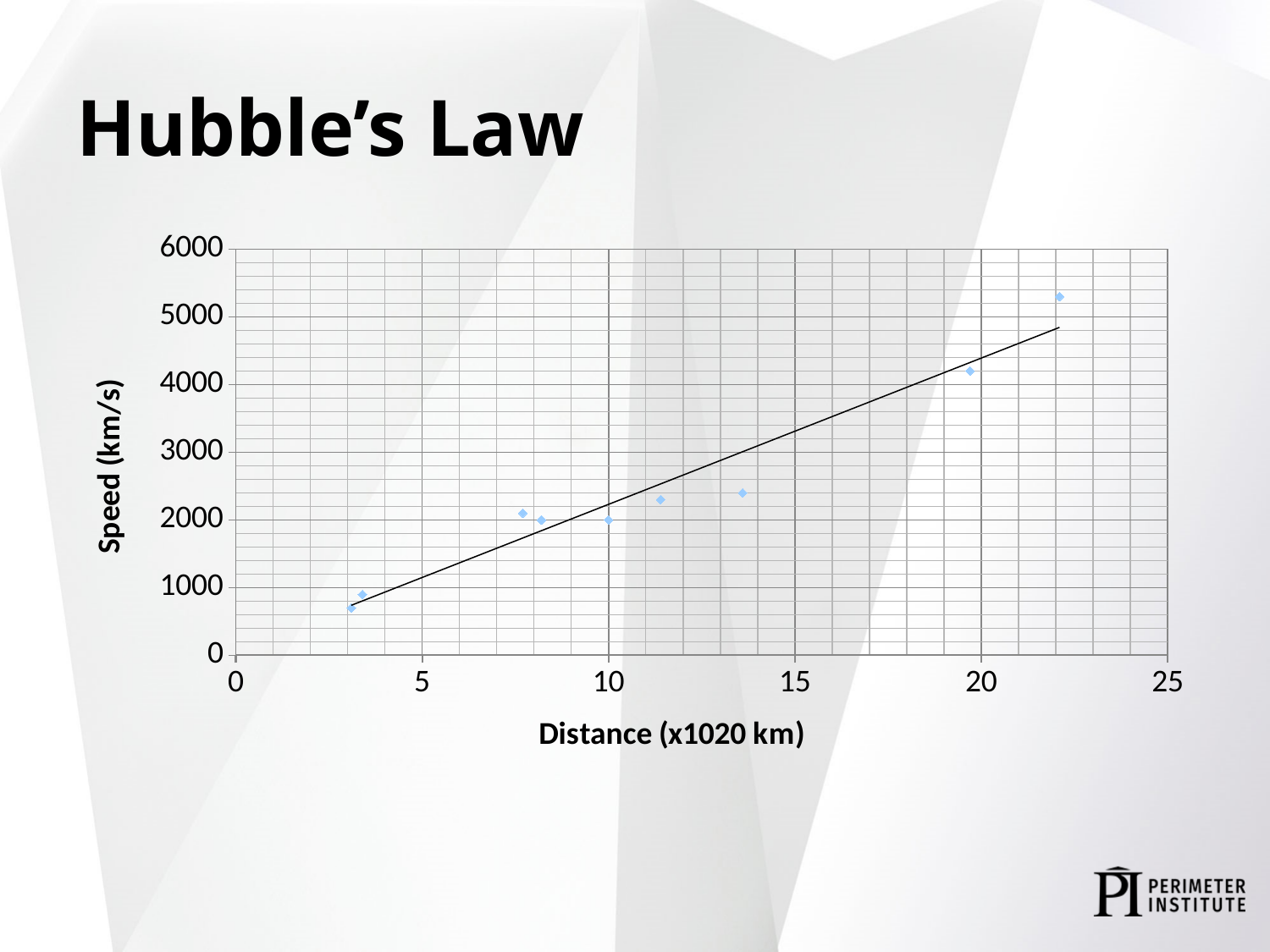
What kind of chart is shown on the slide? scatter plot Which data point has the highest speed: the one at a distance of about 20 or the one at about 22? the one at about 22 How many data points are plotted on the chart? 9 What is the title of the slide containing the chart? Hubble's Law Is the speed of the data point at a distance of about 22 greater or less than 5000 km/s? greater What is the label on the y axis of the chart? Speed (km/s) Is the speed of the data point at a distance of about 20 greater or less than 4000 km/s? greater Is the speed of the data point at a distance of about 14 greater or less than 3000 km/s? less Do the plotted speed values rise or fall as distance increases along the x axis? rise